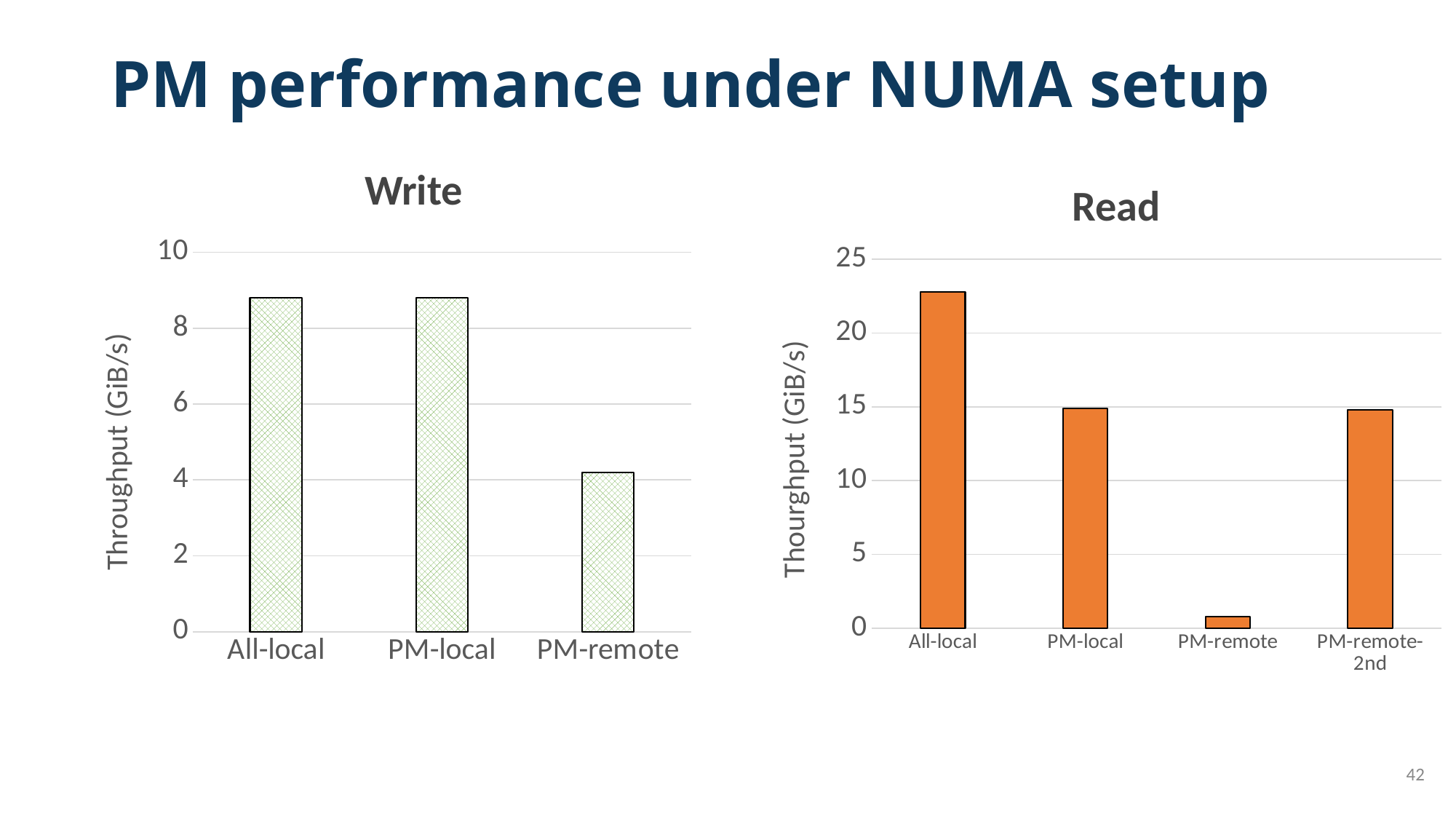
In the Read chart, which category has the lowest throughput? PM-remote In the Write chart, is the value for PM-remote greater or less than 4? greater How many categories are shown on the Write chart? 3 In the Write chart, is the value for PM-local greater or less than 8? greater In the Read chart, is the value for PM-remote greater or less than 5? less In the Read chart, which category has the highest throughput? All-local What kind of chart is the Write chart? bar chart In the Read chart, which is larger, the value for PM-local or the value for PM-remote? PM-local What is the y-axis label of the Write chart? Throughput (GiB/s) How many categories are shown on the Read chart? 4 In the Write chart, which category has the lowest throughput? PM-remote